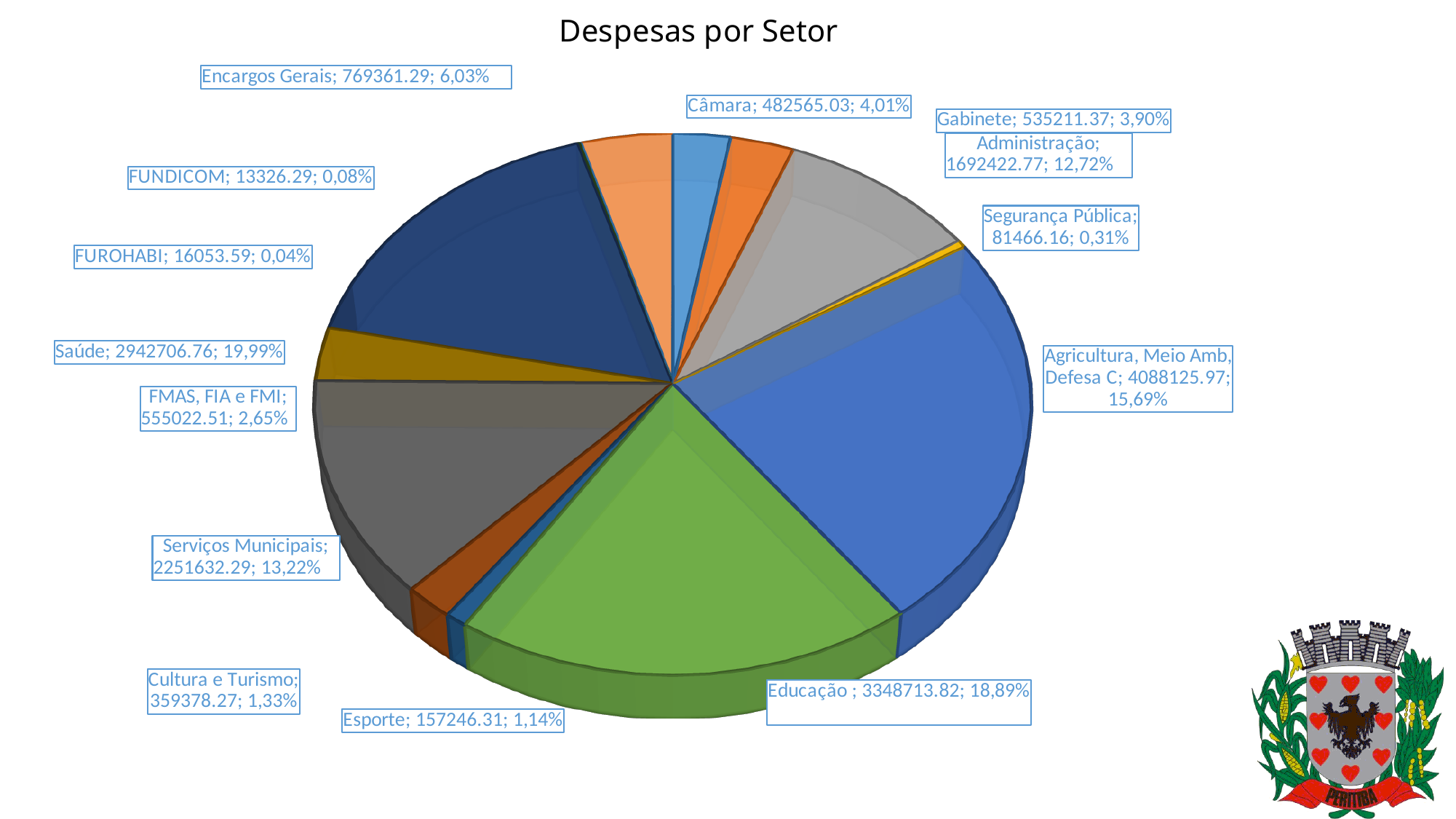
Which sector has the smallest value shown in its label? FUNDICOM What is the value shown for Serviços Municipais? 2251632.29 What is the difference between the values for Educação and Saúde? 406007.06 Which has the larger value, Câmara or Gabinete? Gabinete What percentage is shown for Administração? 12,72% How many sectors are shown in the pie chart? 14 What is the value shown for Educação? 3348713.82 What is the title of the chart? Despesas por Setor Which sector has the largest value shown in its label? Agricultura, Meio Amb, Defesa C What type of chart is shown on the slide? Pie chart What percentage is shown for Segurança Pública? 0,31% Which sector has the highest percentage shown in its label? Saúde